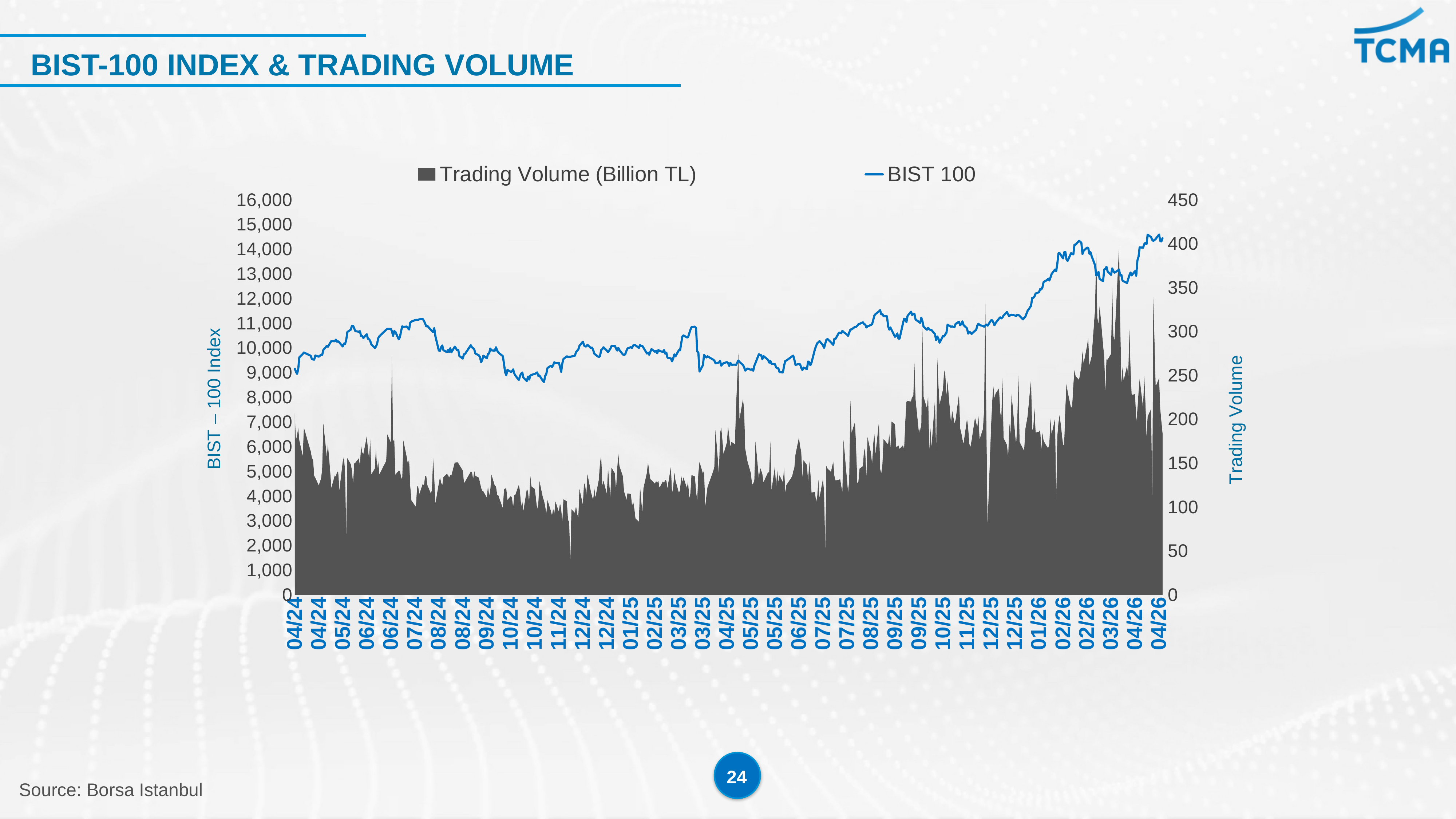
What is the title of the chart's left vertical axis? BIST – 100 Index What kind of chart is used to show the Trading Volume series? Area chart Is the BIST 100 value at 07/24 greater or less than 10,000? greater What kind of chart is used to show the BIST 100 series? Line chart How many series does the legend list? 2 What is the highest value shown on the right-hand Trading Volume axis? 450 Which is higher, the BIST 100 value at 04/26 or at 04/24? 04/26 Is the BIST 100 value at 01/25 greater or less than 12,000? less Is the BIST 100 value at 02/26 greater or less than 12,000? greater Does the BIST 100 index overall rise or fall from 04/24 to 04/26? Rise